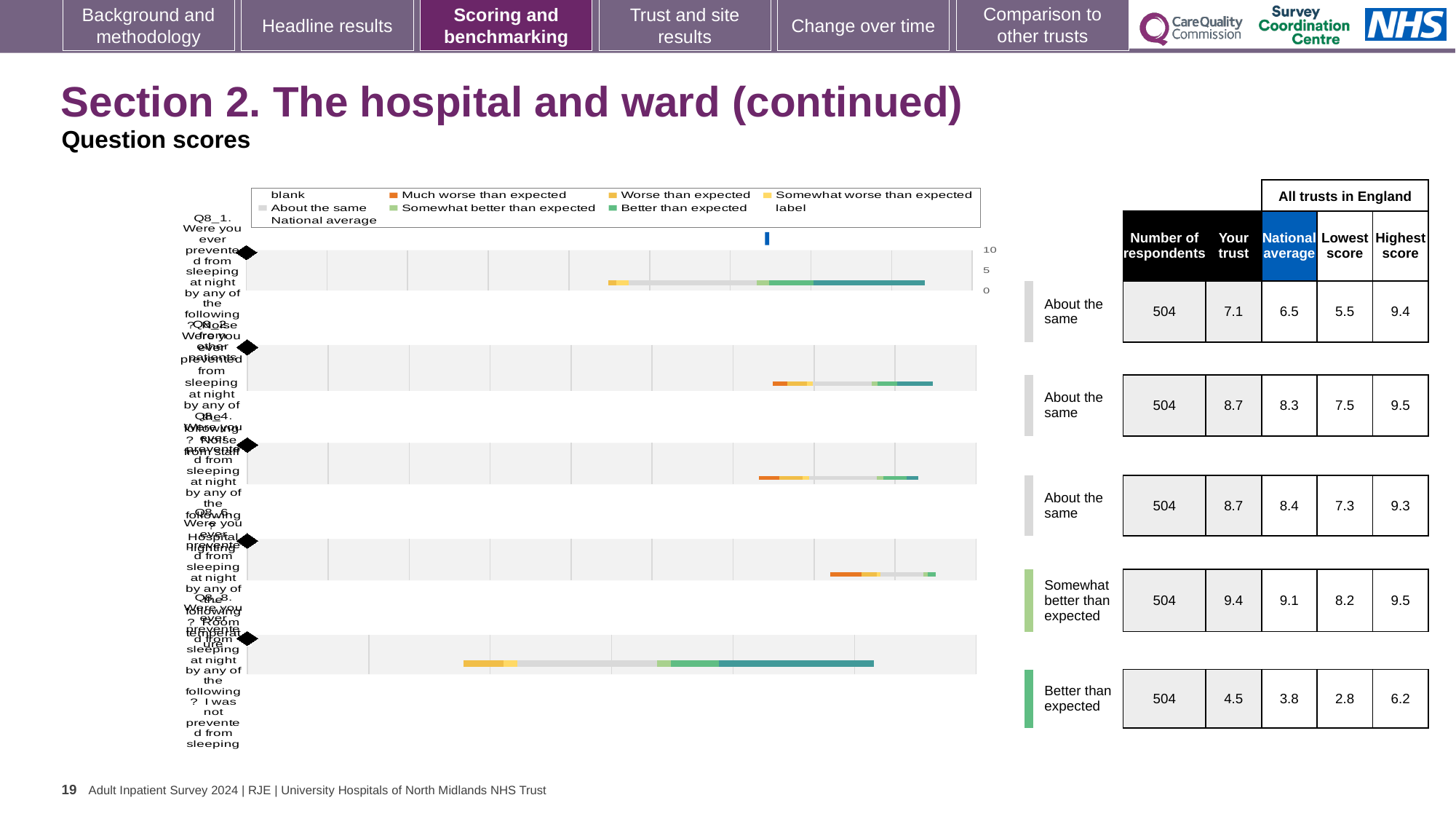
What is the 'Your trust' score for the top (first) row of the chart? 7.1 What kind of chart is shown on the slide? bar chart For the fourth row, which is larger: the 'Your trust' score or the national average? Your trust (9.4) What benchmark label is given to the fourth row? Somewhat better than expected How many question rows (bars) are plotted in the chart? 5 Which row has the lowest 'Your trust' score? the bottom (fifth) row (4.5) For the top (first) row, what is the difference between the 'Your trust' score and the national average? 0.6 How many respondents are listed for each row in the table? 504 Which legend entry is shown in dark orange? Much worse than expected What is the highest score among all trusts in England for the second row? 9.5 What is the national average for the bottom (fifth) row of the chart? 3.8 Which row has the highest 'Your trust' score? the fourth row (9.4)